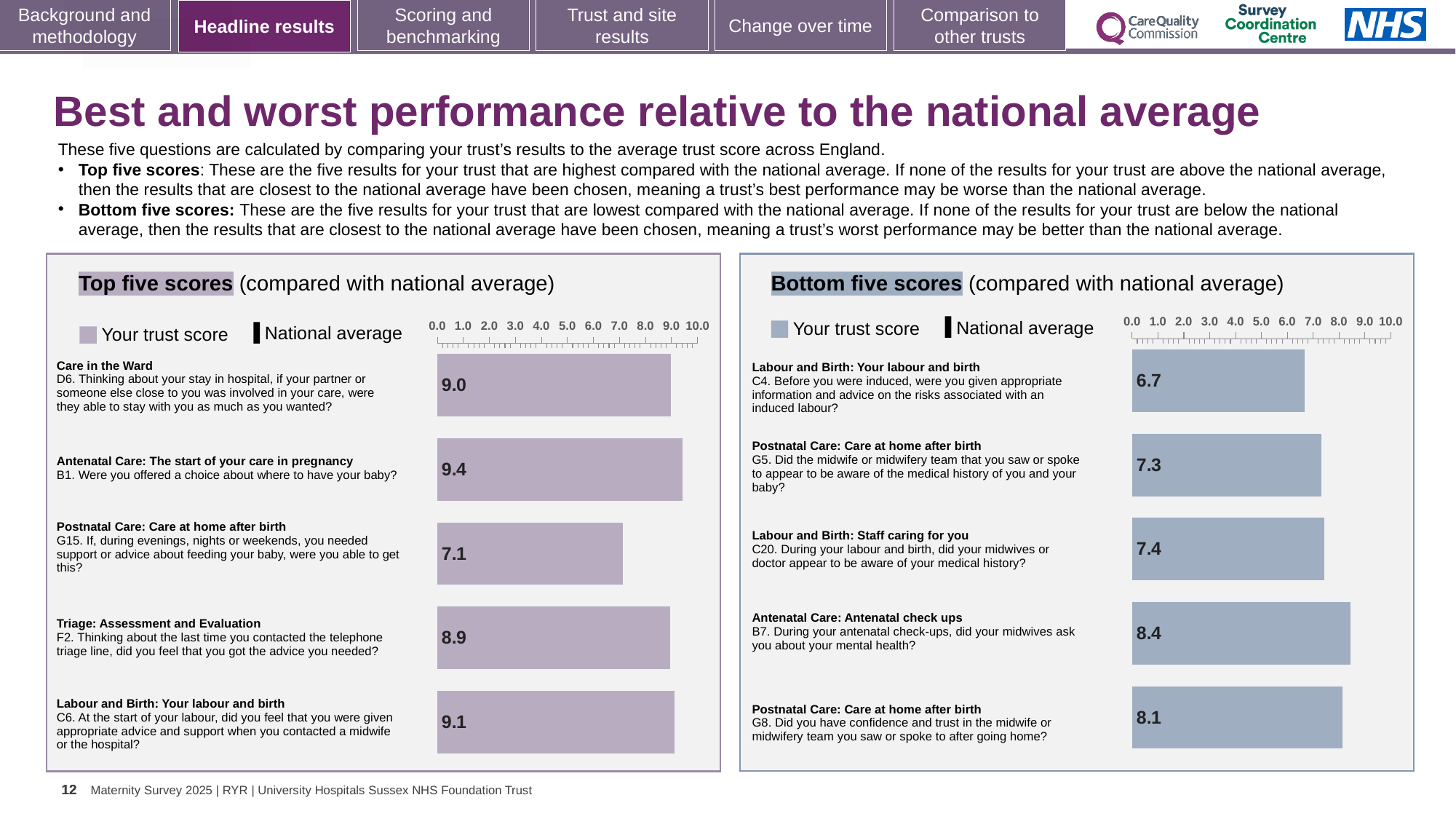
In the Top five scores chart, which question has the highest trust score? B1 How many questions are shown in the Top five scores chart? 5 In the Top five scores chart, what is the trust score for question B1 (Were you offered a choice about where to have your baby?)? 9.4 In the Bottom five scores chart, which has the larger trust score: G5 or B7? B7 In the Bottom five scores chart, which question has the highest trust score? B7 In the Bottom five scores chart, what is the difference between the trust scores for B7 and C4? 1.7 In the Bottom five scores chart, what is the trust score for question C4 about information and advice on the risks of induced labour? 6.7 In the Top five scores chart, what is the difference between the trust scores for B1 and G15? 2.3 In the Top five scores chart, which question has the lowest trust score? G15 In the Top five scores chart, what is the trust score for question F2 about the telephone triage line? 8.9 In the Bottom five scores chart, which question has the lowest trust score? C4 In the Bottom five scores chart, what is the trust score for question G8 about confidence and trust in the midwife team after going home? 8.1